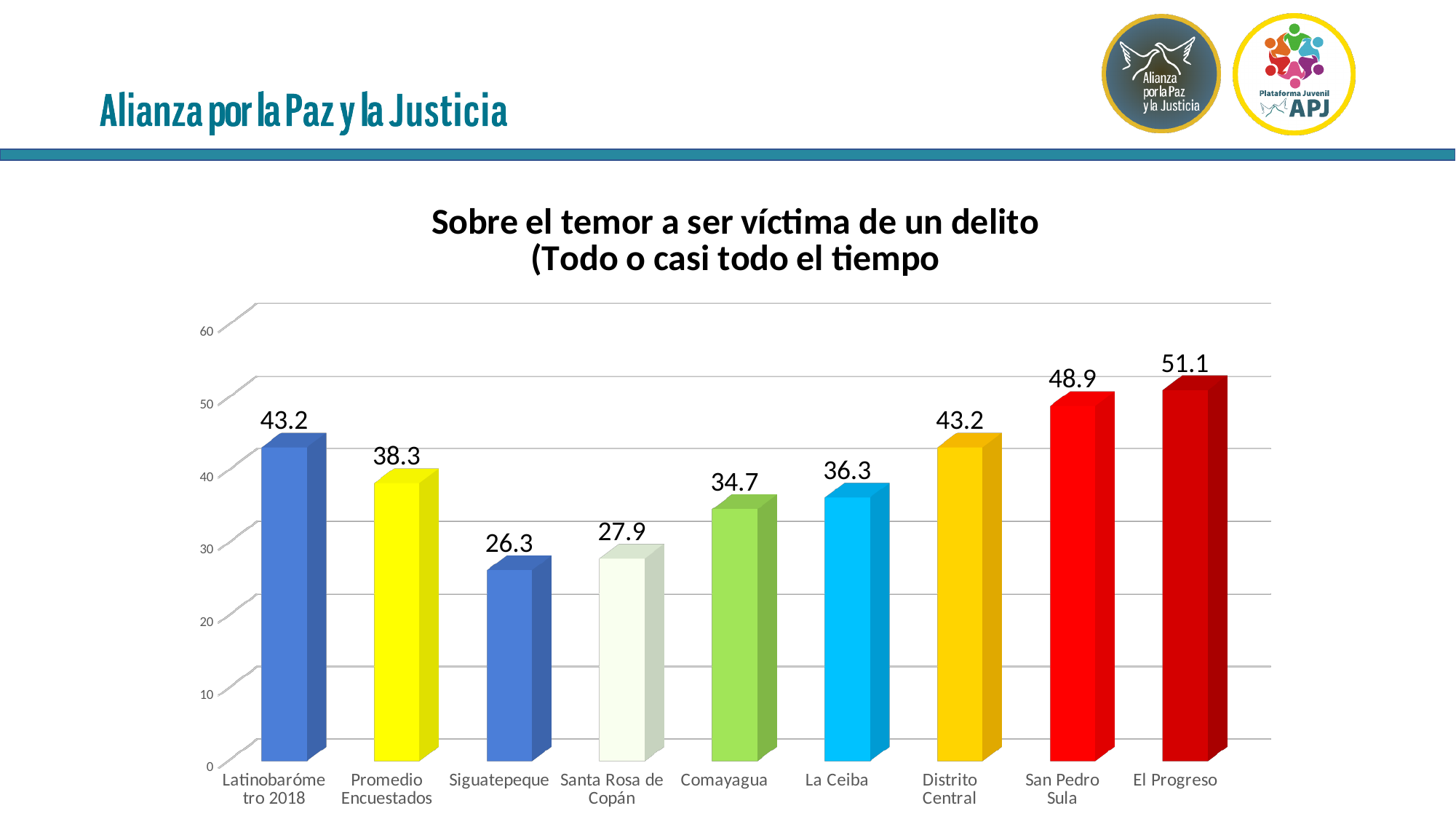
What is the value for La Ceiba? 36.3 What is the value for Siguatepeque? 26.3 How many categories are shown on the x axis? 9 What is the value for Promedio Encuestados? 38.3 What is the difference between the values for San Pedro Sula and Comayagua? 14.2 Which category has the lowest value? Siguatepeque Which category has the highest value? El Progreso What is the title of the chart? Sobre el temor a ser víctima de un delito (Todo o casi todo el tiempo What is the value for El Progreso? 51.1 Is the value for Distrito Central greater or less than 40? greater What kind of chart is shown on the slide? bar chart Which is larger, the value for Santa Rosa de Copán or the value for La Ceiba? La Ceiba